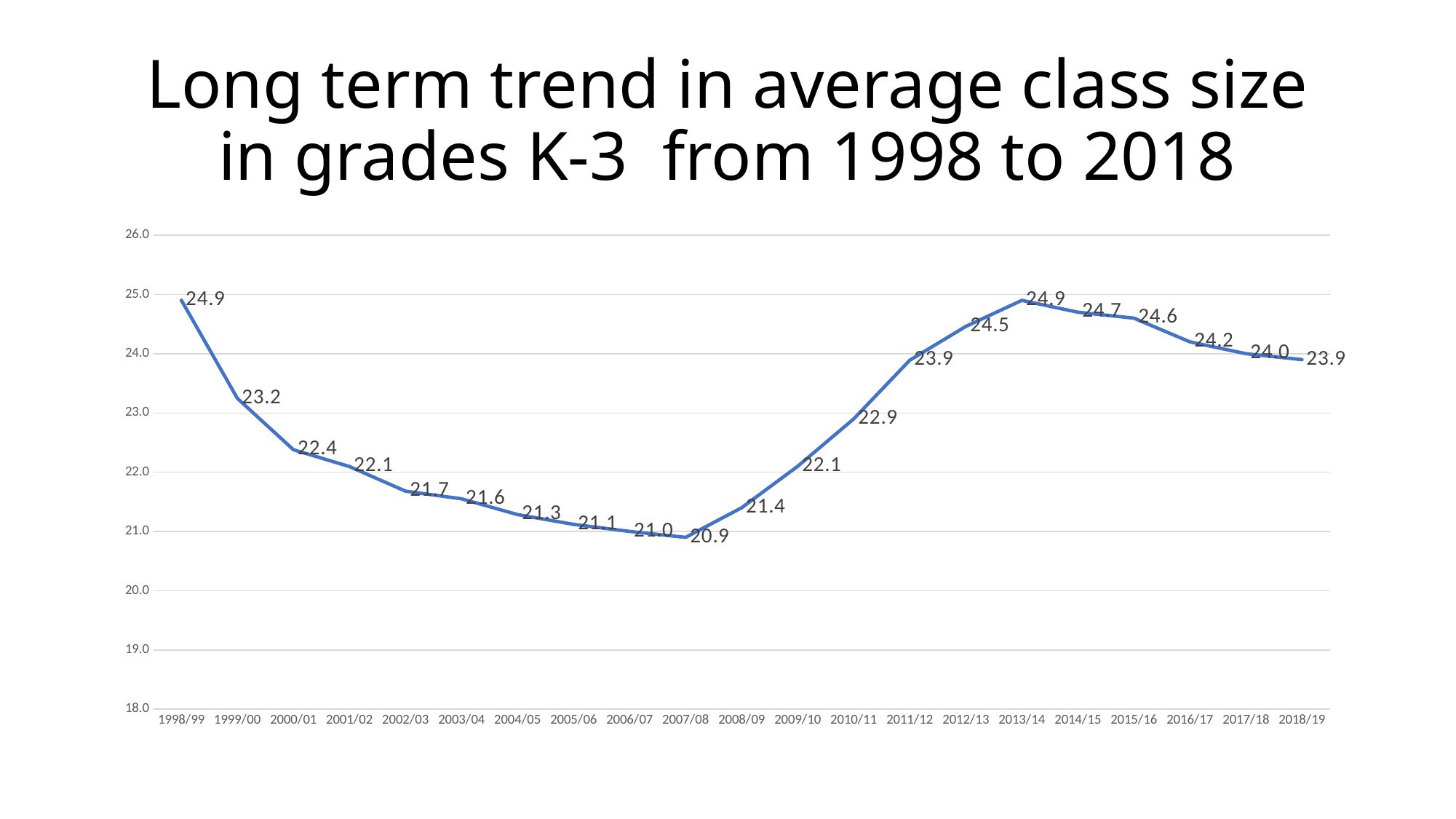
What is the average class size for 2018/19? 23.9 What is the average class size for 2013/14? 24.9 What is the difference between the average class size in 2013/14 and in 2018/19? 1.0 Which school year has the lowest average class size? 2007/08 Is the value for 2011/12 greater or less than 24.0? less What kind of chart is shown on the slide? line chart What is the average class size for 2007/08? 20.9 Do the values rise or fall from 2013/14 to 2018/19? fall Which is larger, the average class size in 1999/00 or in 2010/11? 1999/00 How many school years are plotted on the chart? 21 What is the average class size for 2002/03? 21.7 What is the difference between the average class size in 1998/99 and in 2007/08? 4.0